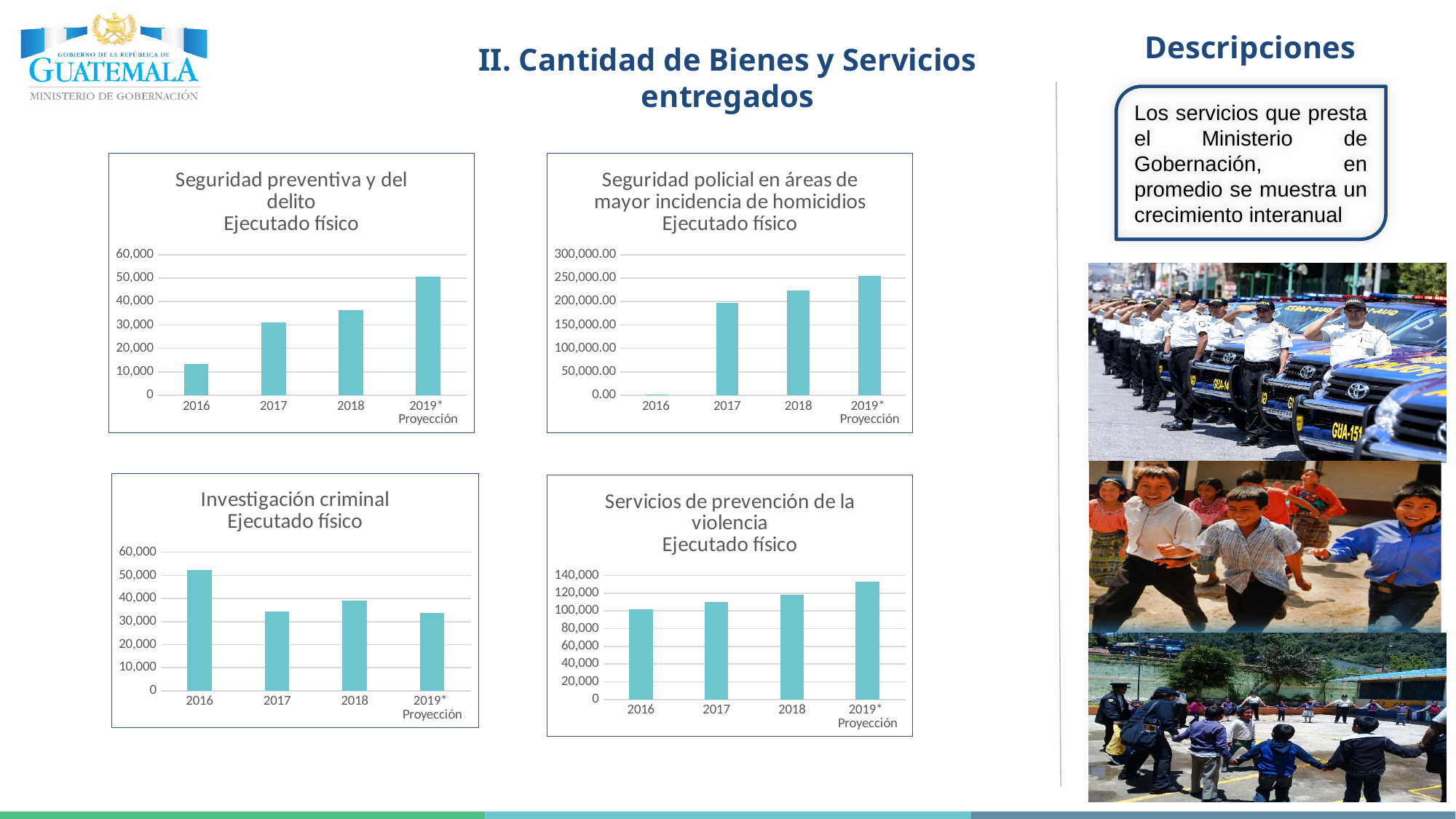
In the 'Seguridad preventiva y del delito' chart, is the value for 2019* Proyección greater or less than 40,000? greater In the 'Seguridad policial en áreas de mayor incidencia de homicidios' chart, do the values rise or fall from 2017 to 2019* Proyección? rise In the 'Seguridad policial en áreas de mayor incidencia de homicidios' chart, which year has the lowest value? 2016 What kind of chart is the 'Investigación criminal' chart? bar chart In the 'Seguridad preventiva y del delito' chart, which year has the lowest value? 2016 In the 'Seguridad preventiva y del delito' chart, which year has the highest value? 2019* Proyección In the 'Seguridad policial en áreas de mayor incidencia de homicidios' chart, is the value for 2017 greater or less than 150,000.00? greater In the 'Servicios de prevención de la violencia' chart, which year has the highest value? 2019* Proyección In the 'Servicios de prevención de la violencia' chart, is the value for 2019* Proyección greater or less than 120,000? greater In the 'Investigación criminal' chart, which year has the highest value? 2016 How many years are shown on the x axis of the 'Servicios de prevención de la violencia' chart? 4 In the 'Investigación criminal' chart, which is larger, the value for 2016 or the value for 2018? 2016